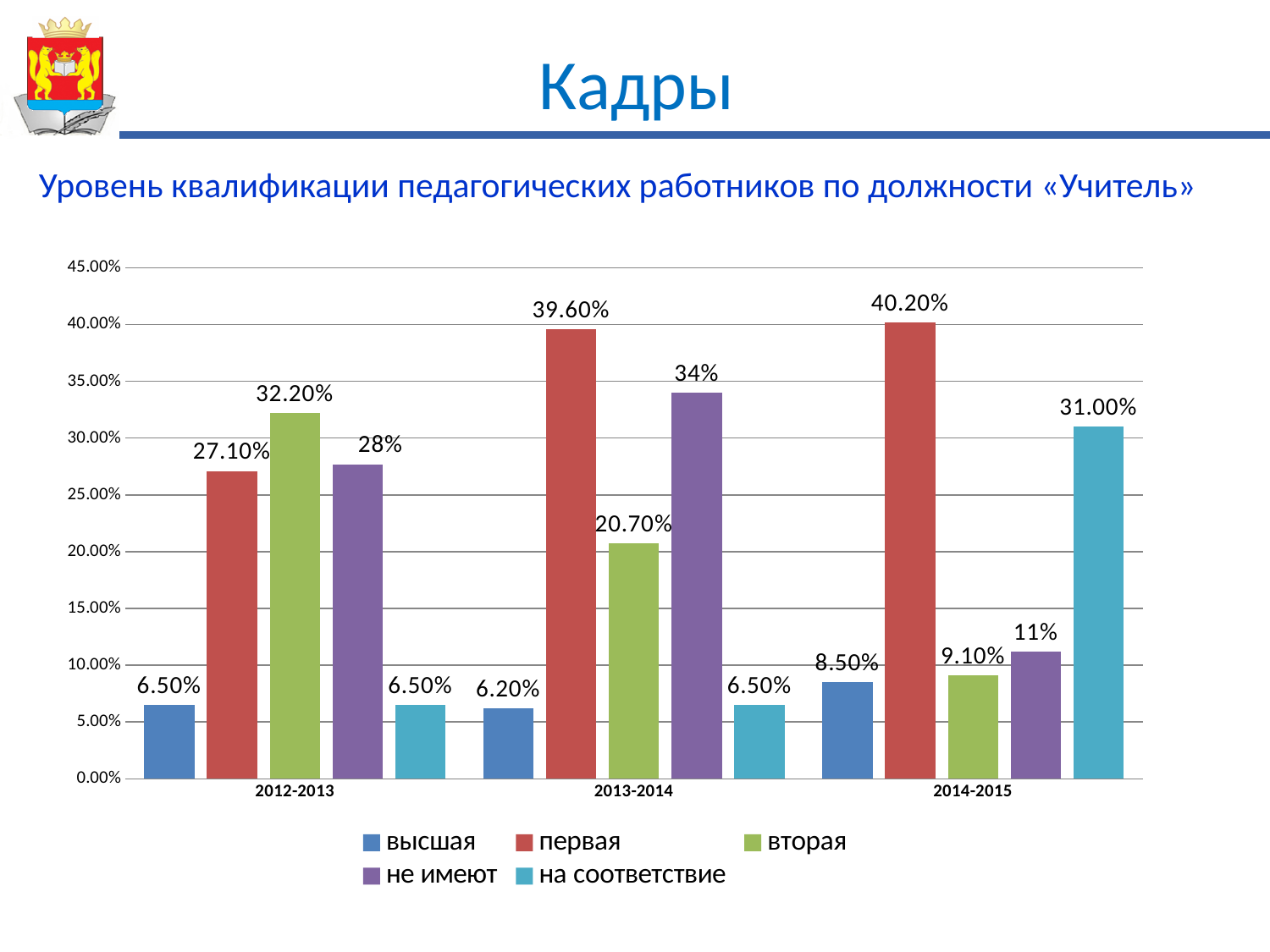
What is the difference between «первая» in 2014-2015 and «первая» in 2012-2013? 13.10% How many series does the legend list? 5 How many year categories are shown on the x axis? 3 What is the value for «первая» in 2013-2014? 39.60% What kind of chart is shown on the slide? bar chart What is the value for «не имеют» in 2013-2014? 34% Which is larger: «вторая» in 2012-2013 or «не имеют» in 2012-2013? вторая Which series has the lowest value in 2013-2014? высшая What is the value for «вторая» in 2012-2013? 32.20% Which series has the highest value in 2014-2015? первая What is the value for «на соответствие» in 2014-2015? 31.00% Does the value for «первая» rise or fall from 2012-2013 to 2014-2015? rise